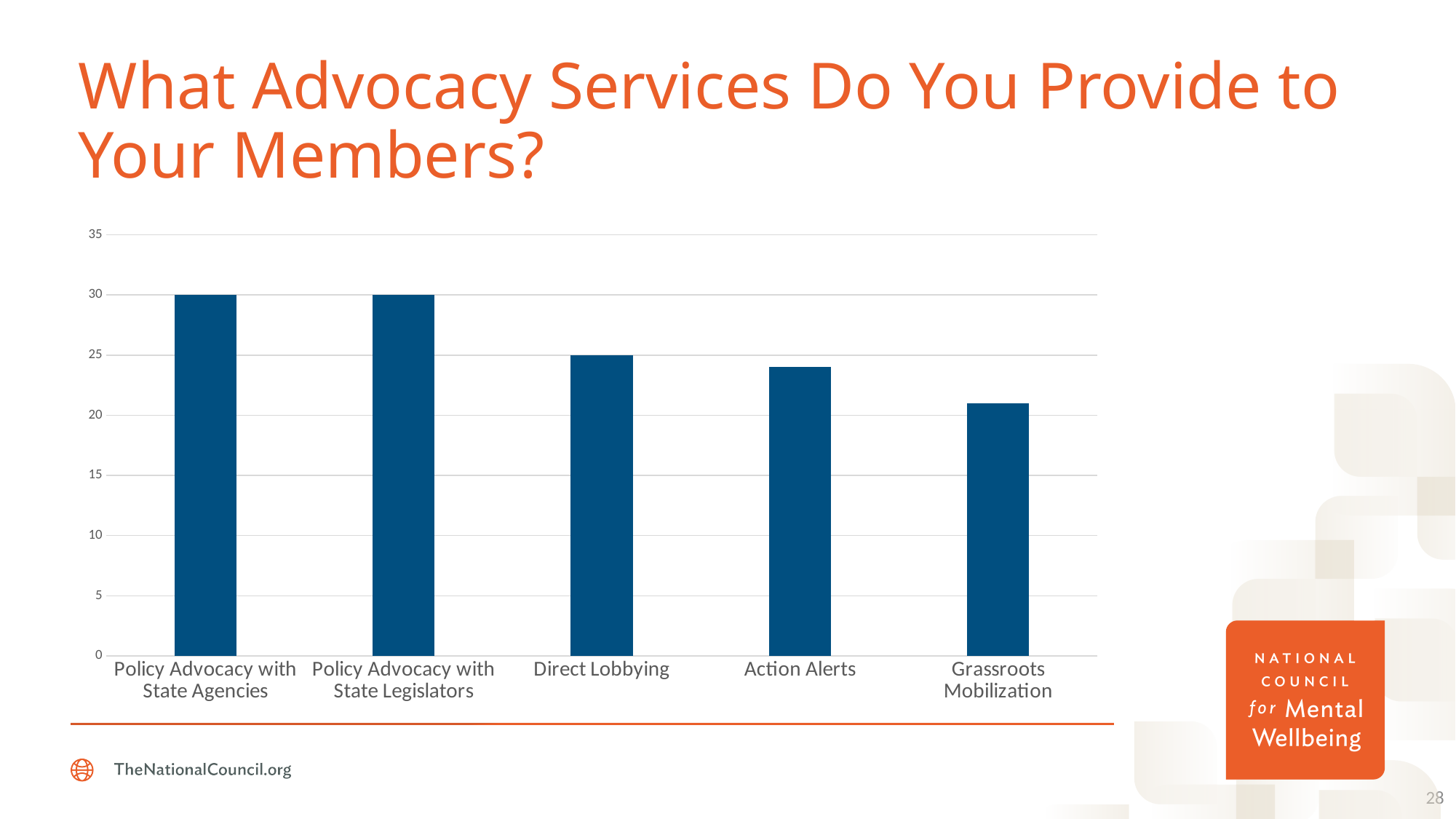
Is the value for Grassroots Mobilization greater or less than 20? greater Which category has the lowest value? Grassroots Mobilization What is the value for Policy Advocacy with State Agencies? 30 What is the title of the slide containing the chart? What Advocacy Services Do You Provide to Your Members? What is the value for Policy Advocacy with State Legislators? 30 What type of chart is shown on the slide? Bar chart Which is larger, the value for Direct Lobbying or the value for Grassroots Mobilization? Direct Lobbying Is the value for Action Alerts greater or less than 25? less What is the value for Direct Lobbying? 25 Do the values rise or fall moving from left to right along the x axis? Fall What is the difference between the value for Policy Advocacy with State Agencies and the value for Direct Lobbying? 5 How many advocacy service categories are shown on the x axis? 5